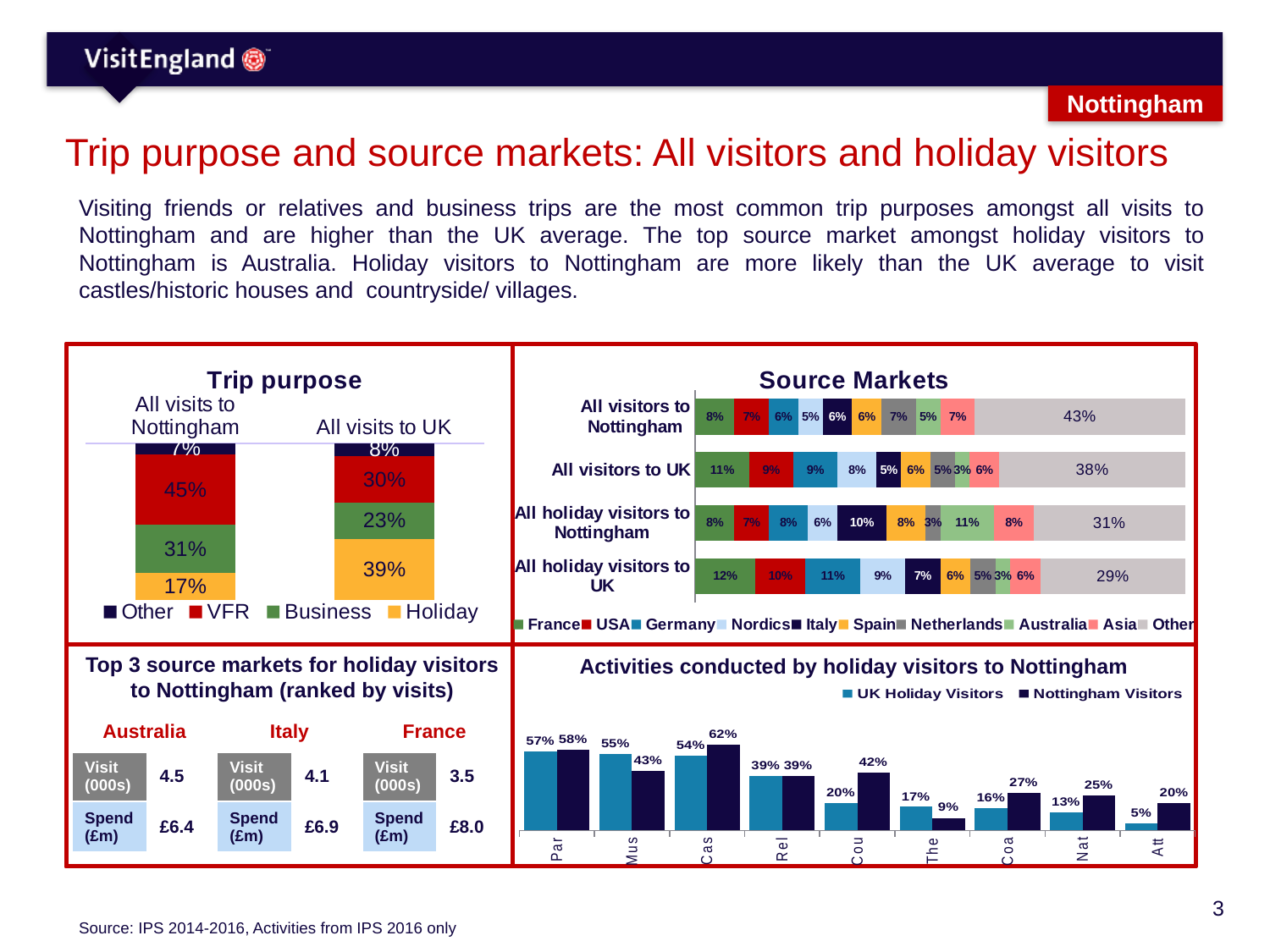
How many series does the legend of the Trip purpose chart list? 4 How many series does the legend of the Source Markets chart list? 10 In the Source Markets chart, what share of all holiday visitors to Nottingham come from Australia? 11% In the Activities conducted by holiday visitors to Nottingham chart, which category has the lowest UK Holiday Visitors value? Att In the Trip purpose chart, what share of all visits to the UK are Holiday? 39% How many categories (bars) are shown in the Source Markets chart? 4 In the Trip purpose chart, what share of all visits to Nottingham are VFR? 45% What type of chart is the Activities conducted by holiday visitors to Nottingham chart? Bar chart In the Source Markets chart, what is the Other share for all visitors to Nottingham? 43% In the Trip purpose chart, what is the difference between the Holiday share for all visits to the UK and for all visits to Nottingham? 22 percentage points In the Activities conducted by holiday visitors to Nottingham chart, what is the Nottingham Visitors value for the category labelled Cas? 62% In the Trip purpose chart, which is larger: the Business share for all visits to Nottingham or for all visits to the UK? All visits to Nottingham